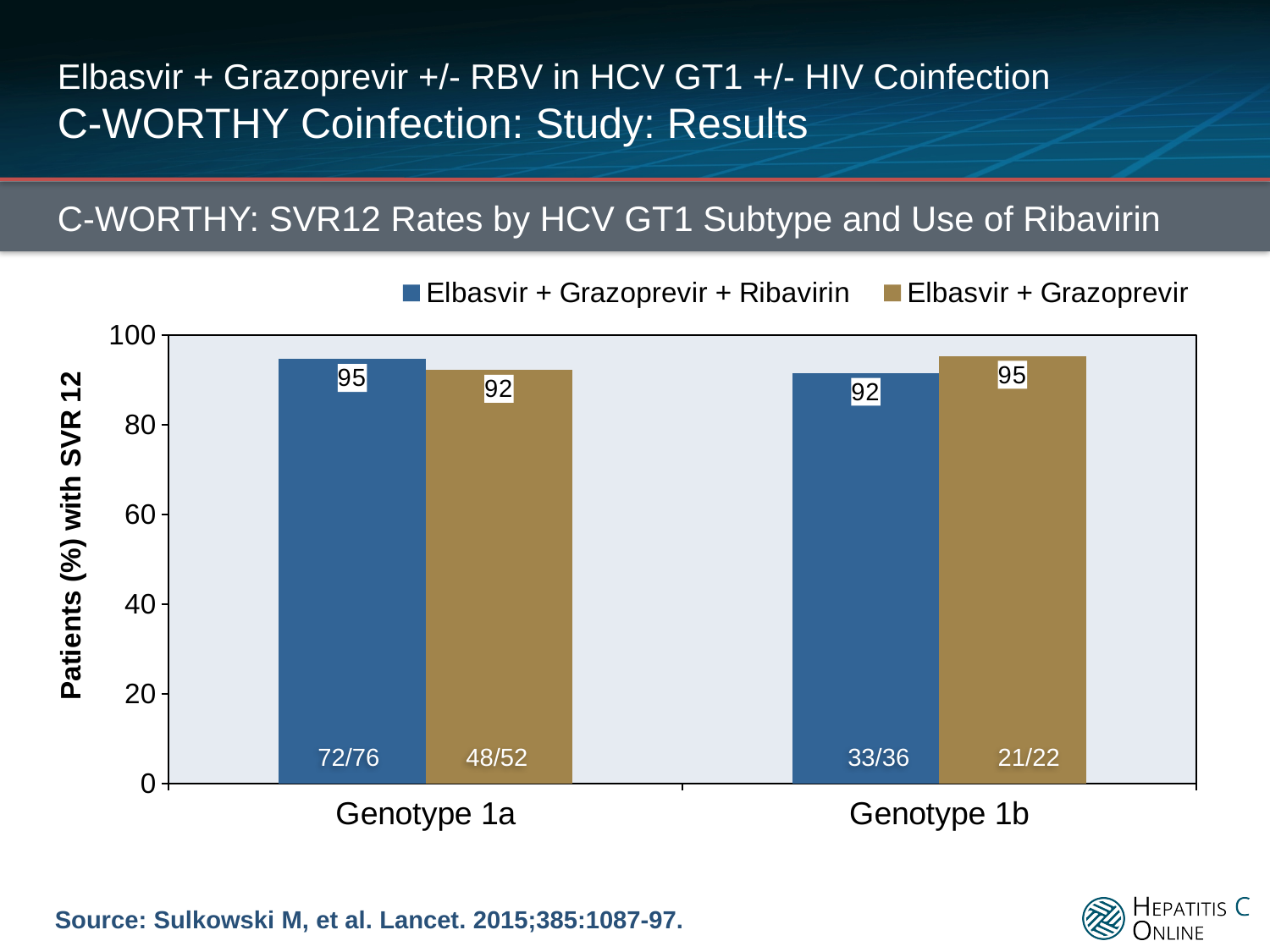
What is the SVR12 rate for Elbasvir + Grazoprevir + Ribavirin in Genotype 1b? 92 What is the SVR12 rate for Elbasvir + Grazoprevir in Genotype 1a? 92 What is the SVR12 rate for Elbasvir + Grazoprevir + Ribavirin in Genotype 1a? 95 How many patients achieved SVR12 out of the total in the Elbasvir + Grazoprevir group for Genotype 1b? 21/22 How many genotype categories are shown on the x axis? 2 What is the difference in SVR12 rate between the two regimens in Genotype 1a? 3 In Genotype 1b, which regimen has the higher SVR12 rate? Elbasvir + Grazoprevir How many series does the legend list? 2 How many patients achieved SVR12 out of the total in the Elbasvir + Grazoprevir + Ribavirin group for Genotype 1a? 72/76 What is the SVR12 rate for Elbasvir + Grazoprevir in Genotype 1b? 95 What kind of chart is shown on the slide? Bar chart What is the label of the y axis? Patients (%) with SVR 12